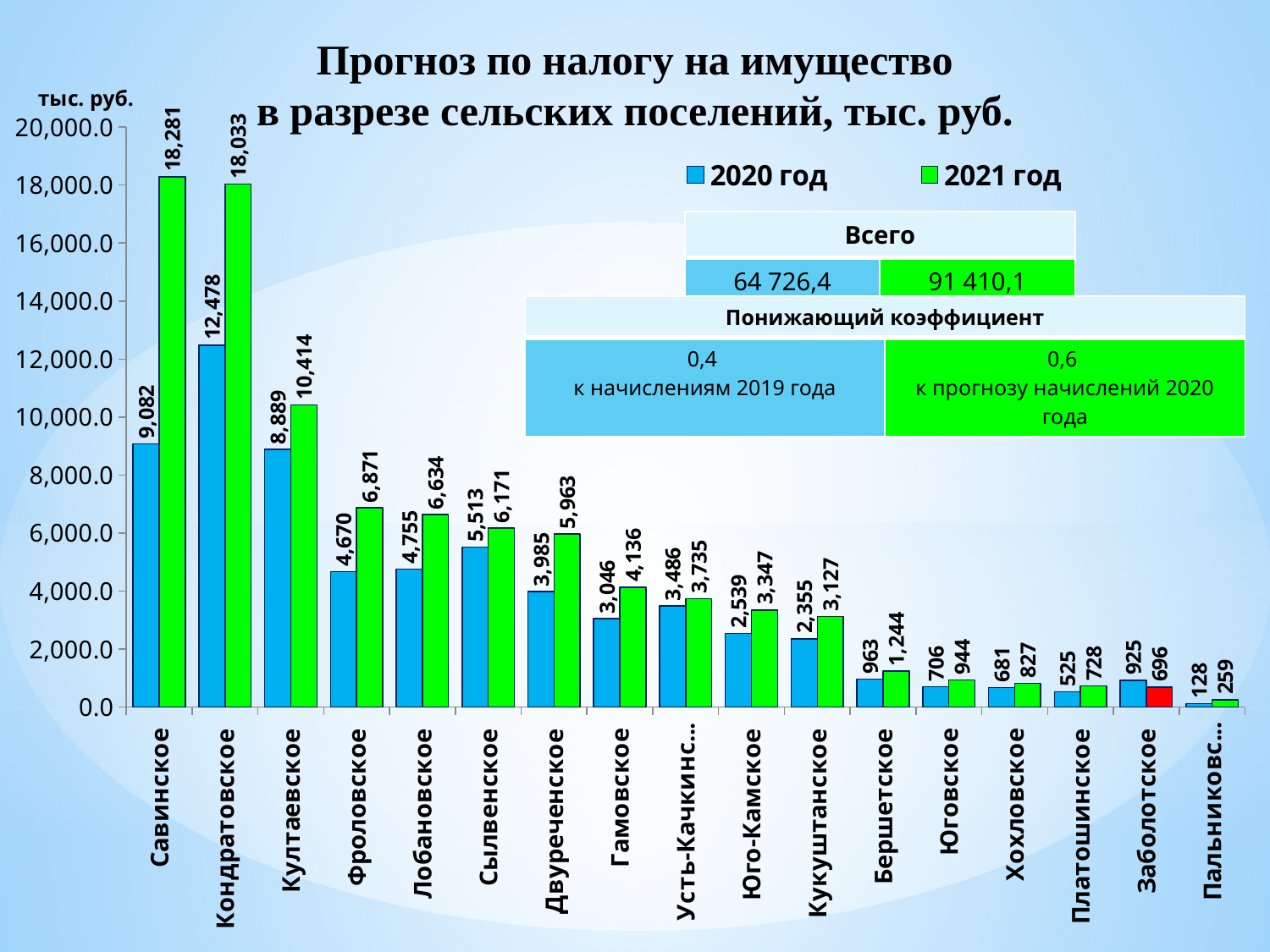
What is the 2021 год value for Заболотское? 696 Which settlement's 2021 год bar is coloured red instead of green? Заболотское Which is larger for Заболотское: the 2020 год value or the 2021 год value? 2020 год What is the 2021 год value for Савинское? 18,281 Which settlement has the highest 2020 год value? Кондратовское What is the 2020 год value for Кондратовское? 12,478 What kind of chart is shown on the slide? bar chart What is the difference between the 2021 год and 2020 год values for Култаевское? 1,525 How many series does the legend list? 2 Which settlement has the lowest 2021 год value? Пальниковское How many settlements are shown on the x axis? 17 Is the 2021 год value for Фроловское greater or less than 6,000.0? greater